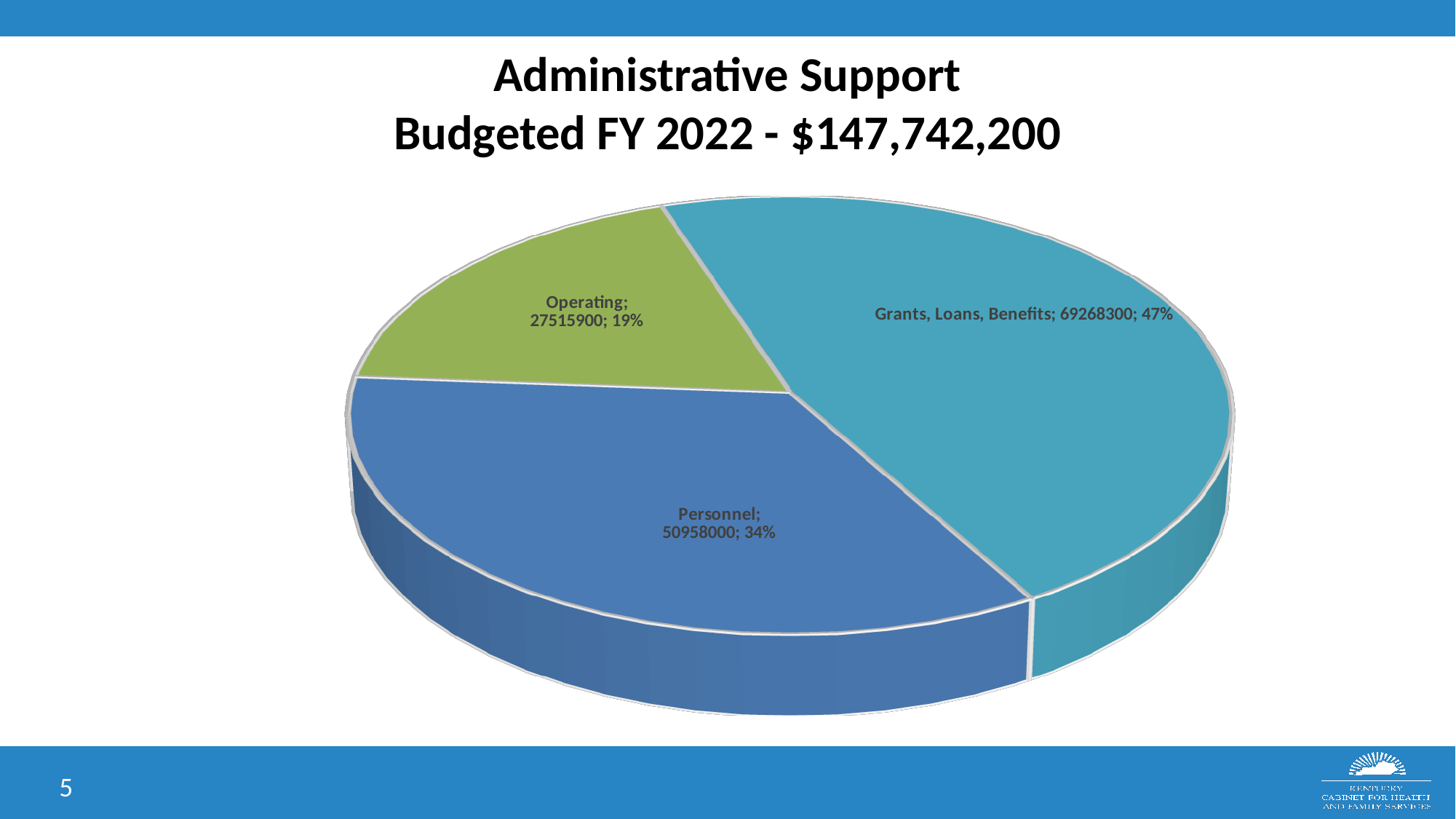
What is the budgeted value for Operating? 27515900 What type of chart is shown on the slide? Pie chart Which is larger, the value for Personnel or the value for Operating? Personnel How many categories are shown in the pie chart? 3 What is the difference between the Grants, Loans, Benefits value and the Personnel value? 18310300 Which category has the smallest slice of the pie? Operating What share of the pie does Operating represent? 19% Which category has the largest slice of the pie? Grants, Loans, Benefits What share of the pie does Grants, Loans, Benefits represent? 47% What is the budgeted value for Grants, Loans, Benefits? 69268300 What is the budgeted value for Personnel? 50958000 What total budget amount is stated in the slide title? $147,742,200